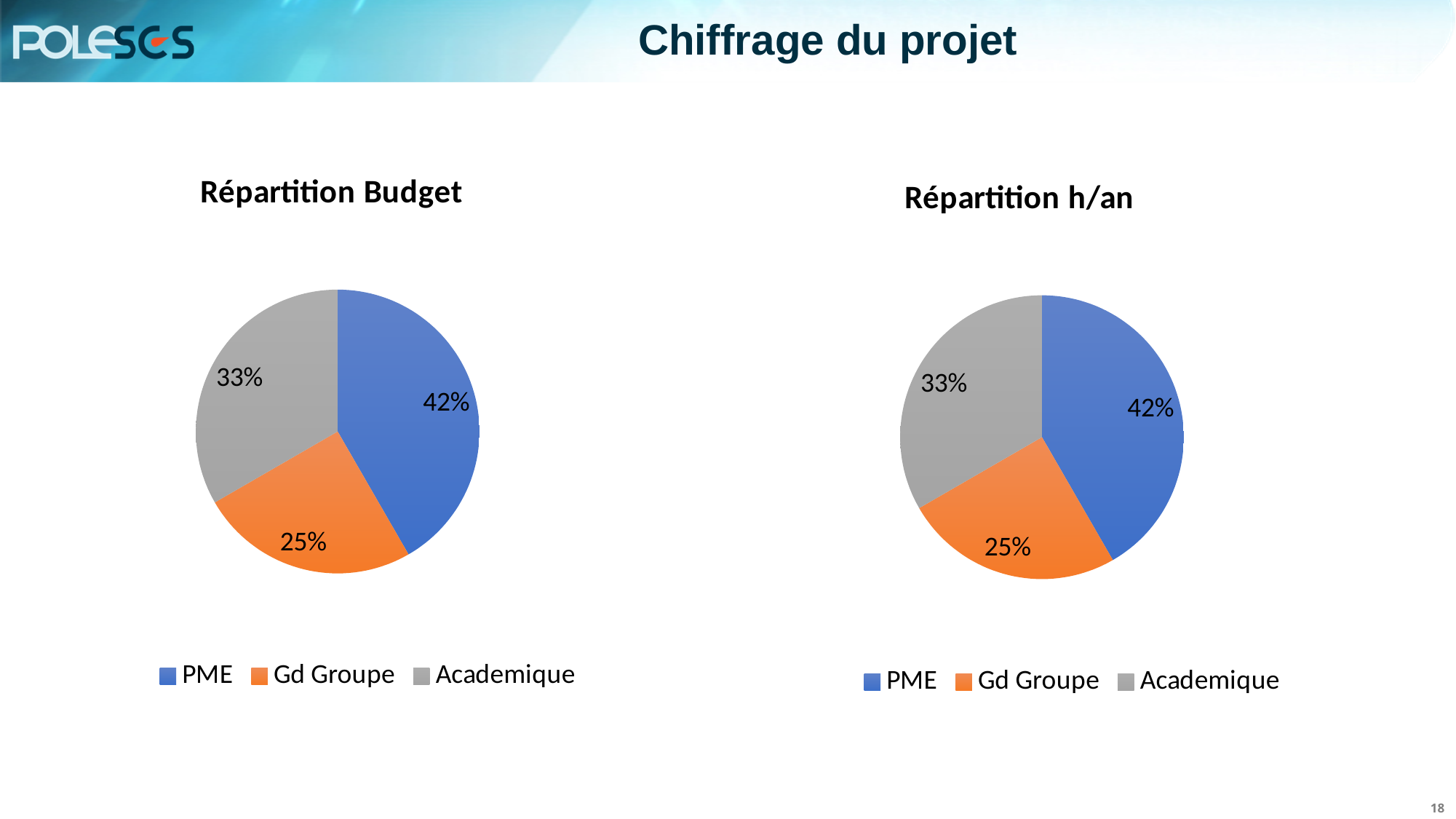
What kind of chart is the 'Répartition h/an' chart? Pie chart In the 'Répartition Budget' chart, what share does Gd Groupe have? 25% In the 'Répartition h/an' chart, which is larger, the Academique share or the Gd Groupe share? Academique In the 'Répartition h/an' chart, what share does Gd Groupe have? 25% In the 'Répartition Budget' chart, what share does PME have? 42% How many categories does the 'Répartition Budget' chart show? 3 In the 'Répartition h/an' chart, which category has the smallest slice? Gd Groupe In the 'Répartition Budget' chart, which category has the largest slice? PME In the 'Répartition Budget' chart, what is the difference between the PME share and the Gd Groupe share? 17%